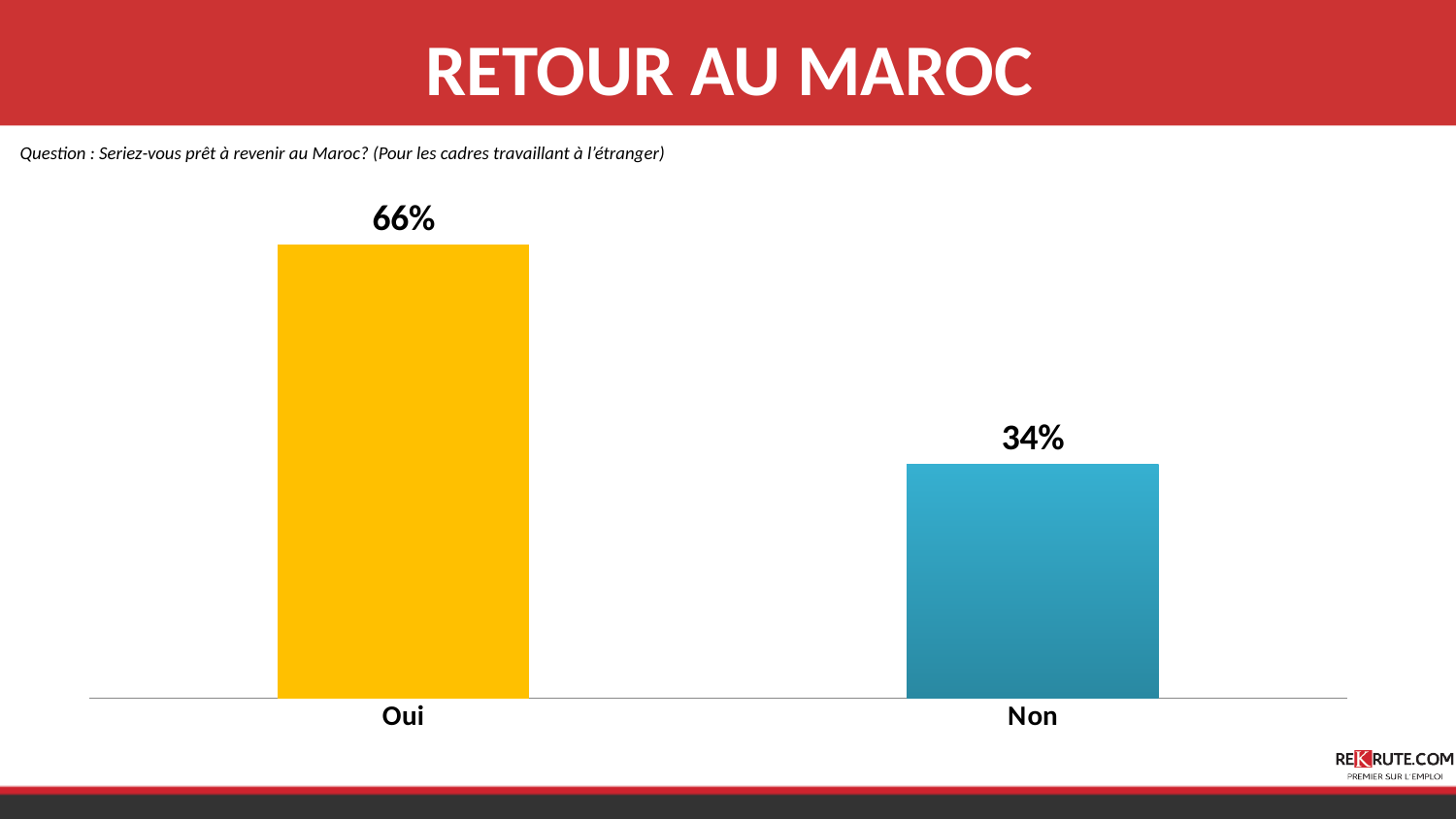
How many categories are shown in the chart? 2 What is the difference between the values for Oui and Non? 32% What is the value for Non? 34% Which is larger, the value for Oui or the value for Non? Oui What is the value for Oui? 66% What kind of chart is shown on the slide? Bar chart Which category has the lowest value? Non What is the total of the two values shown in the chart? 100% Which category has the highest value? Oui What colour is the bar for Oui? Yellow What is the title of the slide? RETOUR AU MAROC